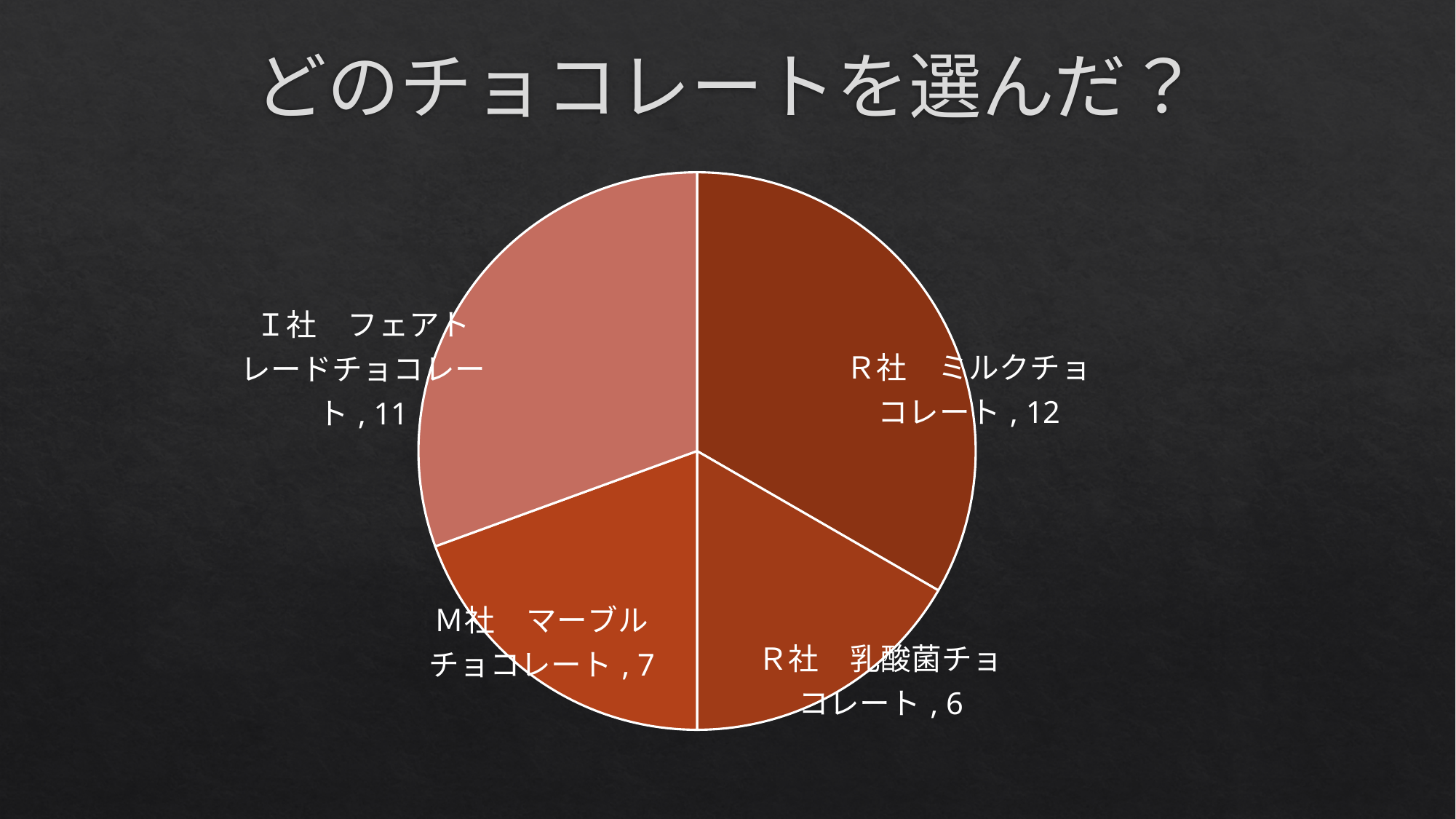
What type of chart is shown on the slide? Pie chart Which chocolate has the smallest slice? R社 乳酸菌チョコレート What is the total of all four slices? 36 How many slices does the pie chart have? 4 What is the difference between the values for R社 ミルクチョコレート and R社 乳酸菌チョコレート? 6 Which chocolate has the largest slice? R社 ミルクチョコレート What is the value for R社 乳酸菌チョコレート? 6 What is the value for M社 マーブルチョコレート? 7 What is the value for I社 フェアトレードチョコレート? 11 What is the chart's title? どのチョコレートを選んだ？ What share of the pie does R社 ミルクチョコレート represent? 33.3% What is the value for R社 ミルクチョコレート? 12